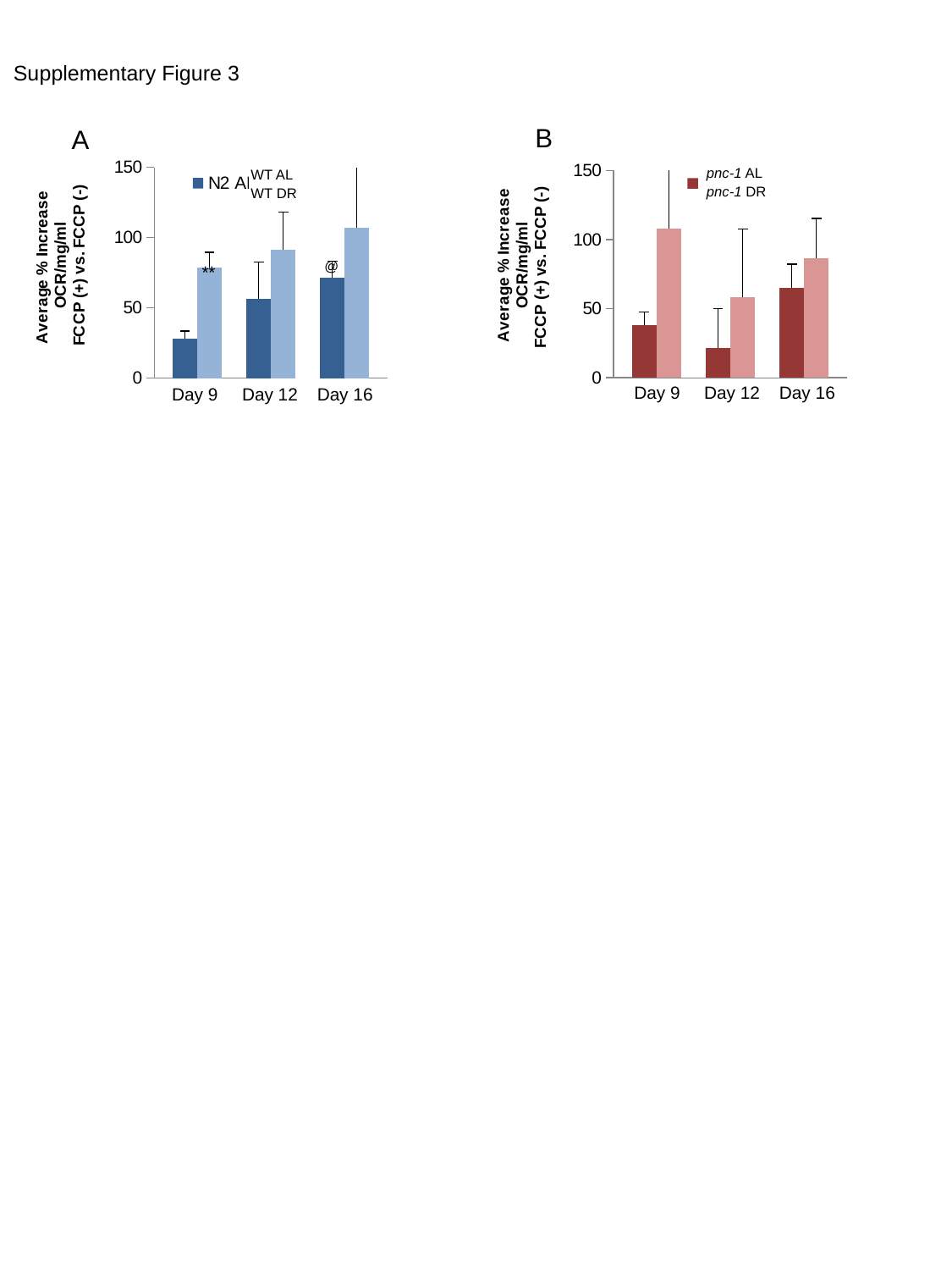
In chart B, is the value for pnc-1 DR at Day 9 greater or less than 100? greater In chart B, at which day is the pnc-1 AL value lowest? Day 12 What kind of chart is chart A? bar chart In chart B, at which day is the pnc-1 DR value highest? Day 9 In chart A, at Day 9, which is larger: WT AL or WT DR? WT DR In chart B, is the value for pnc-1 AL at Day 12 greater or less than 50? less In chart A, is the value for WT AL at Day 9 greater or less than 50? less In chart B, at Day 12, which is larger: pnc-1 AL or pnc-1 DR? pnc-1 DR How many series does the legend of chart B list? 2 How many categories are shown on the x axis of chart B? 3 In chart A, do the WT AL values rise or fall from Day 9 to Day 16? rise